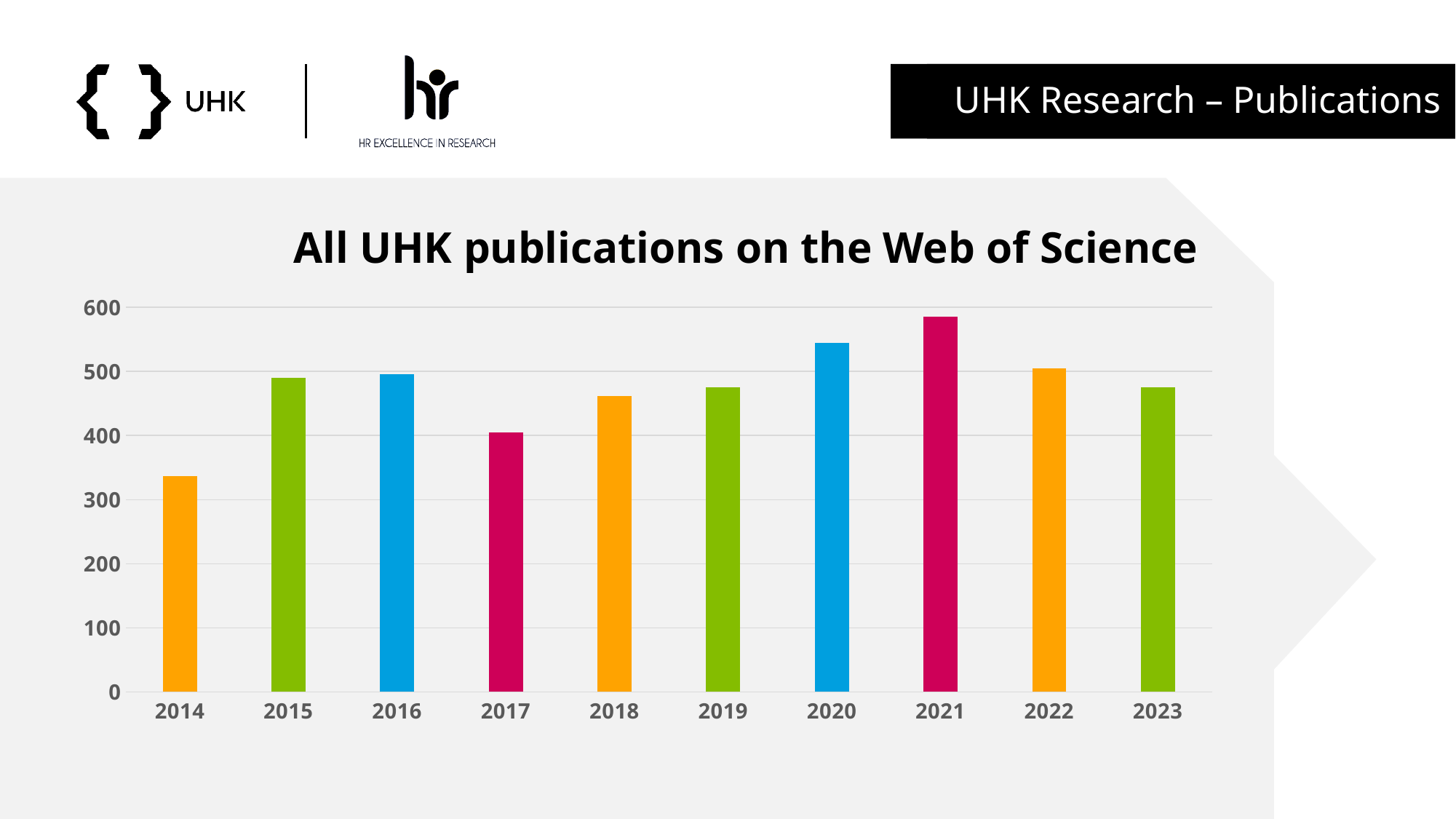
Is the value for 2017 greater or less than 500? less What is the title of the chart? All UHK publications on the Web of Science Is the value for 2014 greater or less than 300? greater Which year has more publications, 2022 or 2018? 2022 Do the values rise or fall from 2014 to 2016? rise Which year has the highest number of publications? 2021 How many years are shown on the x axis of the chart? 10 What type of chart is shown on the slide? bar chart Which year has more publications, 2020 or 2017? 2020 Is the value for 2020 greater or less than 500? greater Which year has the lowest number of publications? 2014